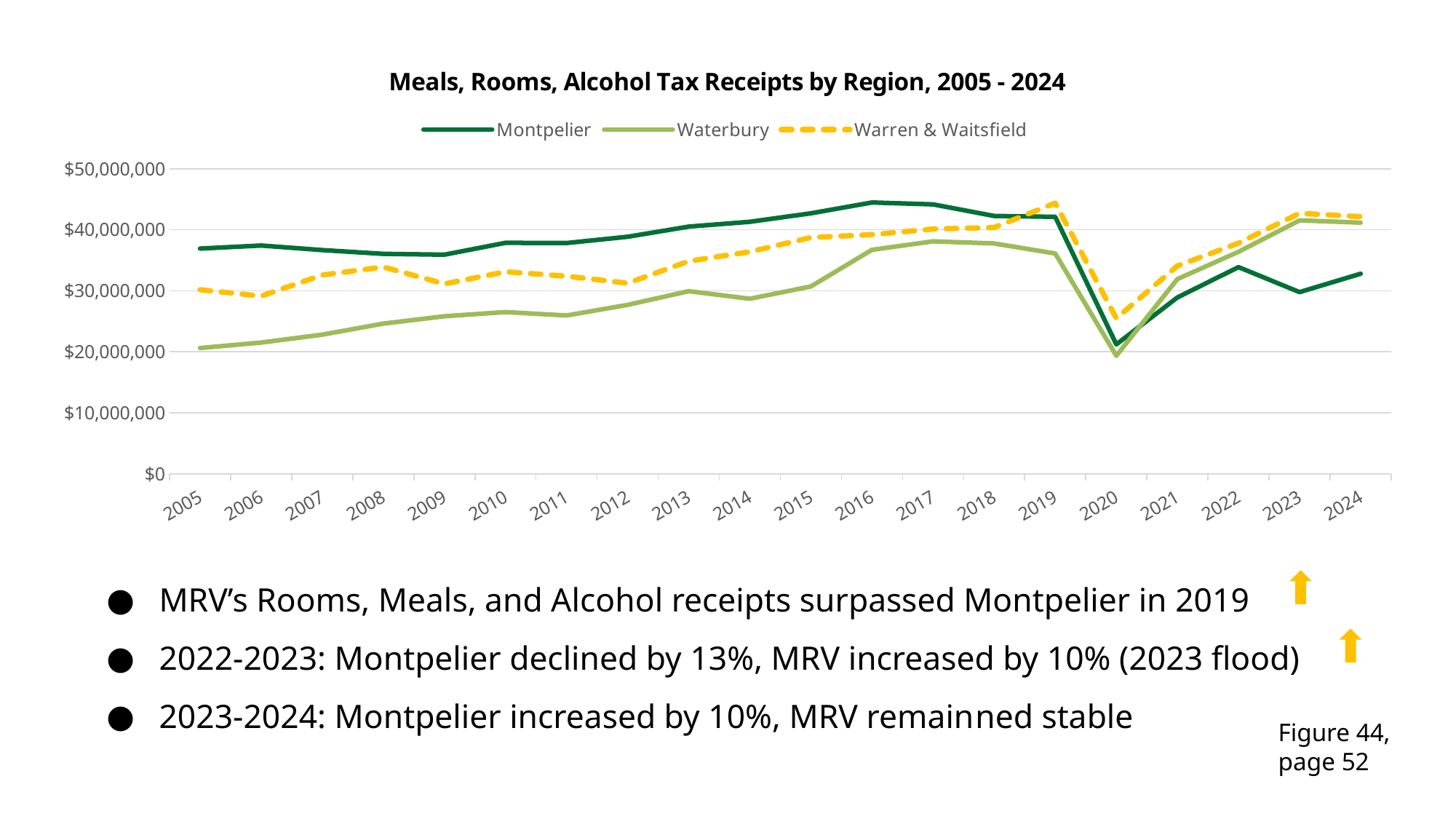
In 2024, which is larger: Montpelier or Warren & Waitsfield? Warren & Waitsfield Is the value for Warren & Waitsfield in 2024 greater or less than $40,000,000? greater Which series is drawn with a dashed line? Warren & Waitsfield Is the value for Warren & Waitsfield in 2020 greater or less than $30,000,000? less Is the value for Waterbury in 2005 greater or less than $30,000,000? less How many years are plotted along the x axis? 20 What is the title of the chart? Meals, Rooms, Alcohol Tax Receipts by Region, 2005 - 2024 How many series does the legend list? 3 In which year does the Montpelier line reach its lowest value? 2020 What kind of chart is shown on the slide? line chart In 2010, which is larger: Waterbury or Warren & Waitsfield? Warren & Waitsfield